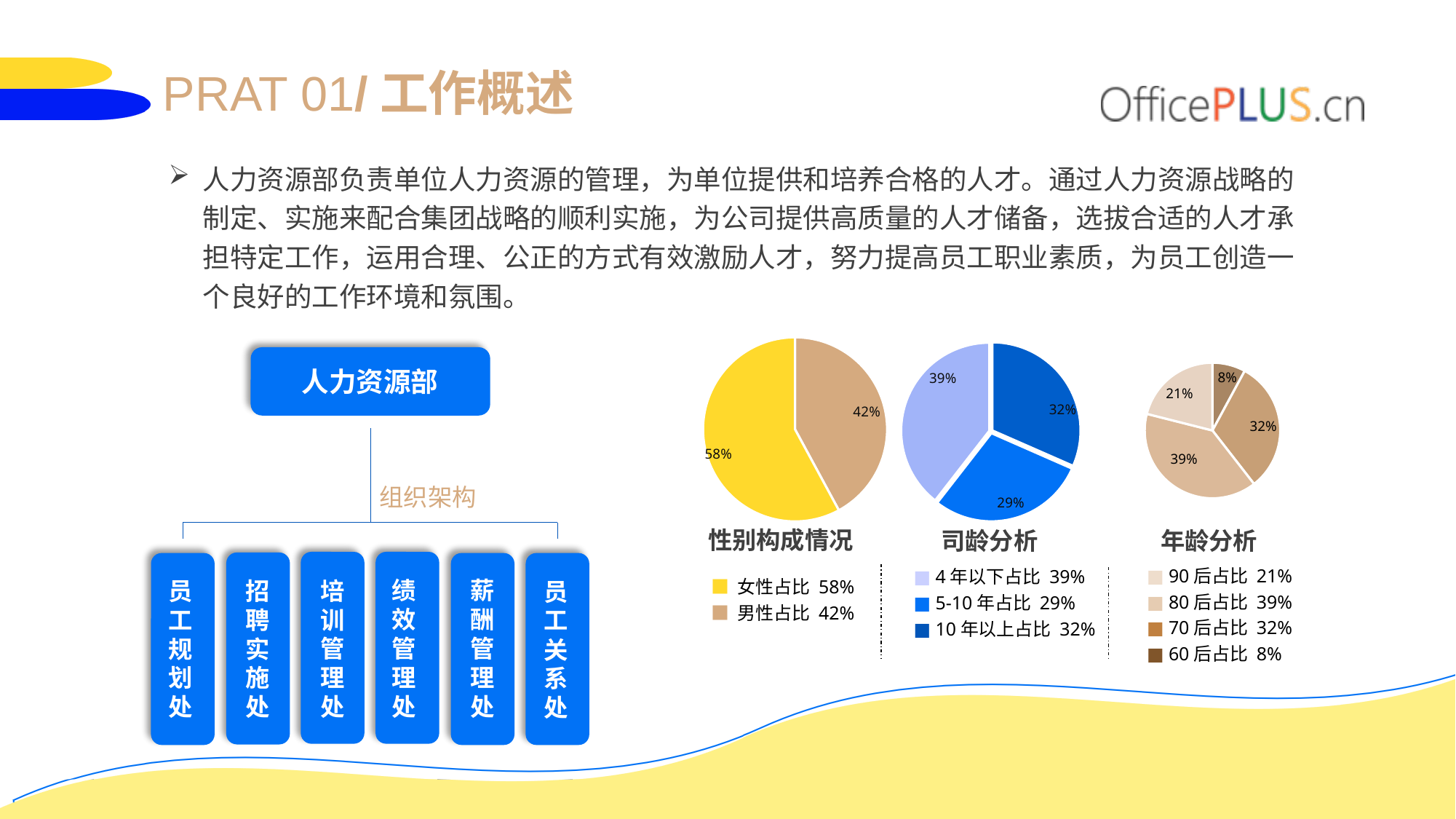
In the 司龄分析 pie chart, which category has the largest share? 4 年以下占比 What type of chart is the 年龄分析 chart? pie chart In the 性别构成情况 pie chart, what share is 男性占比? 42% In the 性别构成情况 pie chart, what share is 女性占比? 58% In the 年龄分析 pie chart, what share is 60 后占比? 8% In the 年龄分析 pie chart, which is larger, 90 后占比 or 70 后占比? 70 后占比 In the 司龄分析 pie chart, how many categories are shown? 3 In the 司龄分析 pie chart, what share is 5-10 年占比? 29% In the 司龄分析 pie chart, which category has the smallest share? 5-10 年占比 In the 年龄分析 pie chart, how many categories does the legend list? 4 In the 年龄分析 pie chart, which category has the largest share? 80 后占比 In the 性别构成情况 pie chart, what is the difference between 女性占比 and 男性占比? 16%